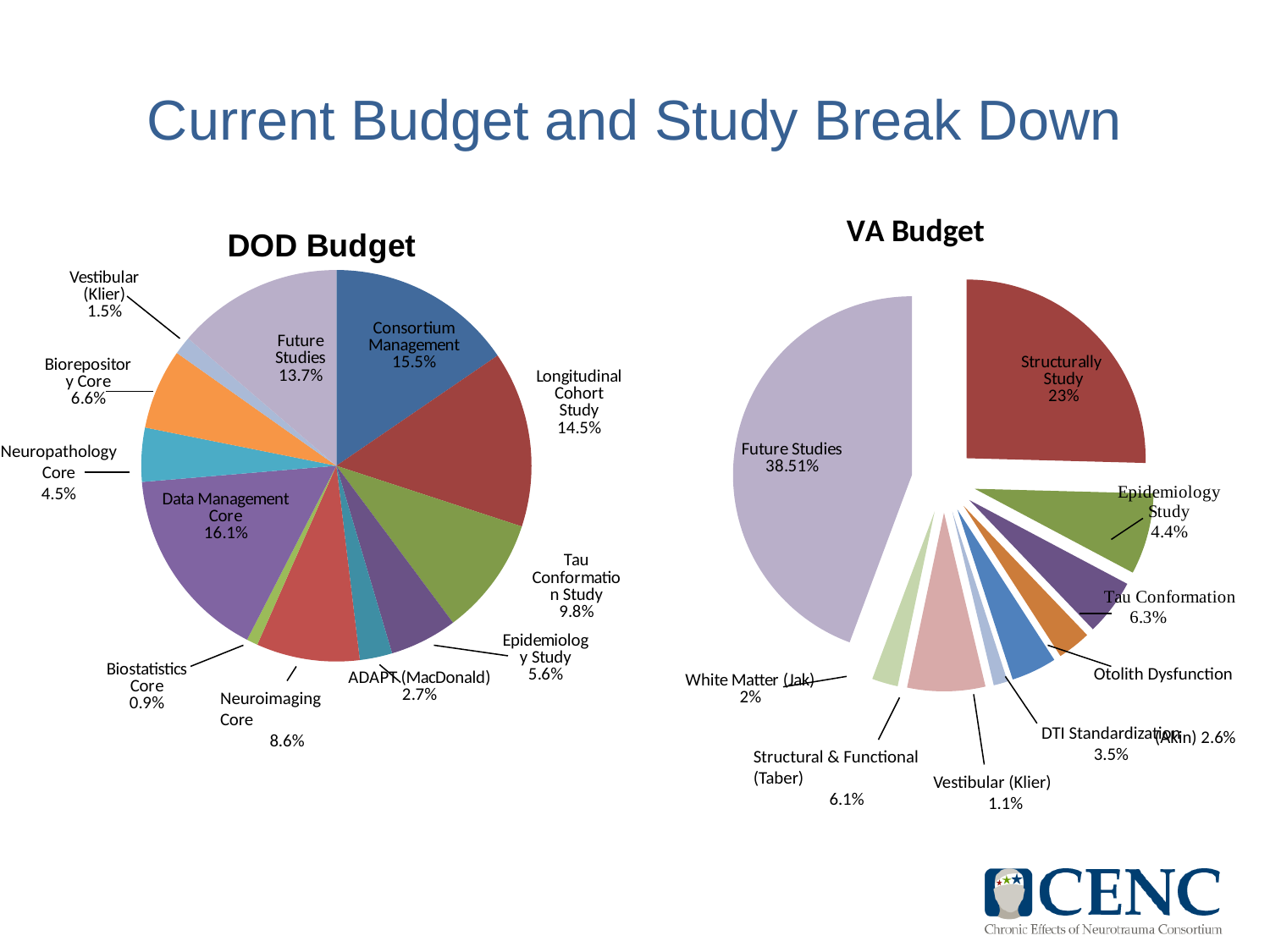
What type of chart is the DOD Budget chart? Pie chart In the VA Budget chart, what is the difference between the Tau Conformation and Epidemiology Study percentages? 1.9% What is the title of the chart on the right side of the slide? VA Budget In the VA Budget chart, which category has the largest slice? Future Studies In the VA Budget chart, what percentage is Future Studies? 38.51% In the DOD Budget chart, what is the difference between the Longitudinal Cohort Study and Tau Conformation Study percentages? 4.7% How many slices does the DOD Budget pie chart have? 12 In the DOD Budget chart, what percentage is Consortium Management? 15.5% In the DOD Budget chart, which category has the largest slice? Data Management Core In the DOD Budget chart, what share does the Data Management Core slice represent? 16.1% In the DOD Budget chart, which is larger: Neuroimaging Core or Biorepository Core? Neuroimaging Core In the DOD Budget chart, which category has the smallest slice? Biostatistics Core